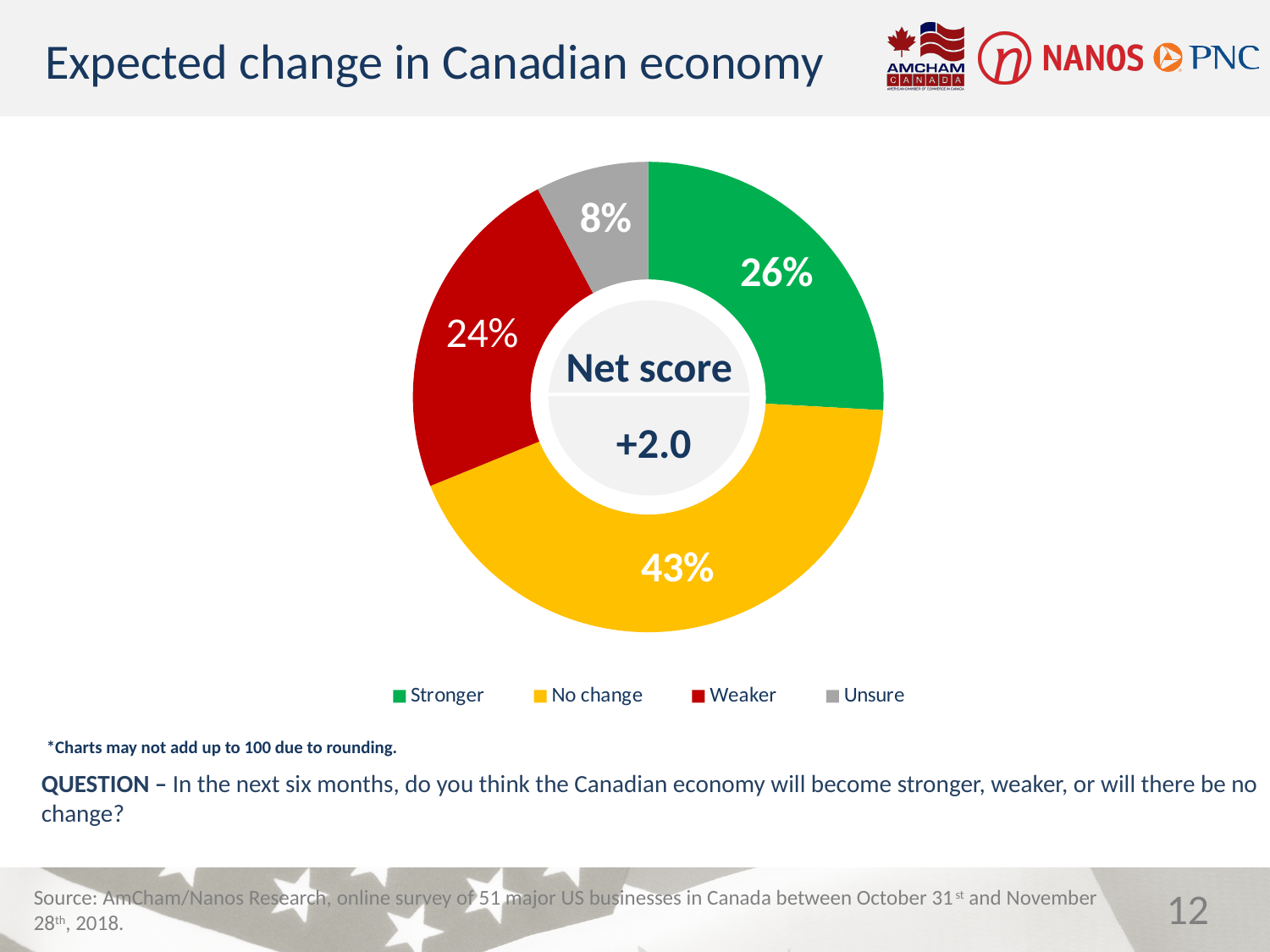
What percentage of respondents are unsure about the expected change in the Canadian economy? 8% What percentage of respondents expect the Canadian economy to become weaker? 24% What colour represents the 'Weaker' category in the chart? Red How many categories does the legend list? 4 What net score is shown in the centre of the chart? +2.0 Which response category has the largest share of the pie? No change What is the difference in percentage points between the 'No change' and 'Stronger' shares? 17 Which share is larger, 'Stronger' or 'Weaker'? Stronger What kind of chart is shown on the slide? Doughnut chart What percentage of respondents expect no change in the Canadian economy? 43% Which response category has the smallest share of the pie? Unsure What percentage of respondents expect the Canadian economy to become stronger? 26%